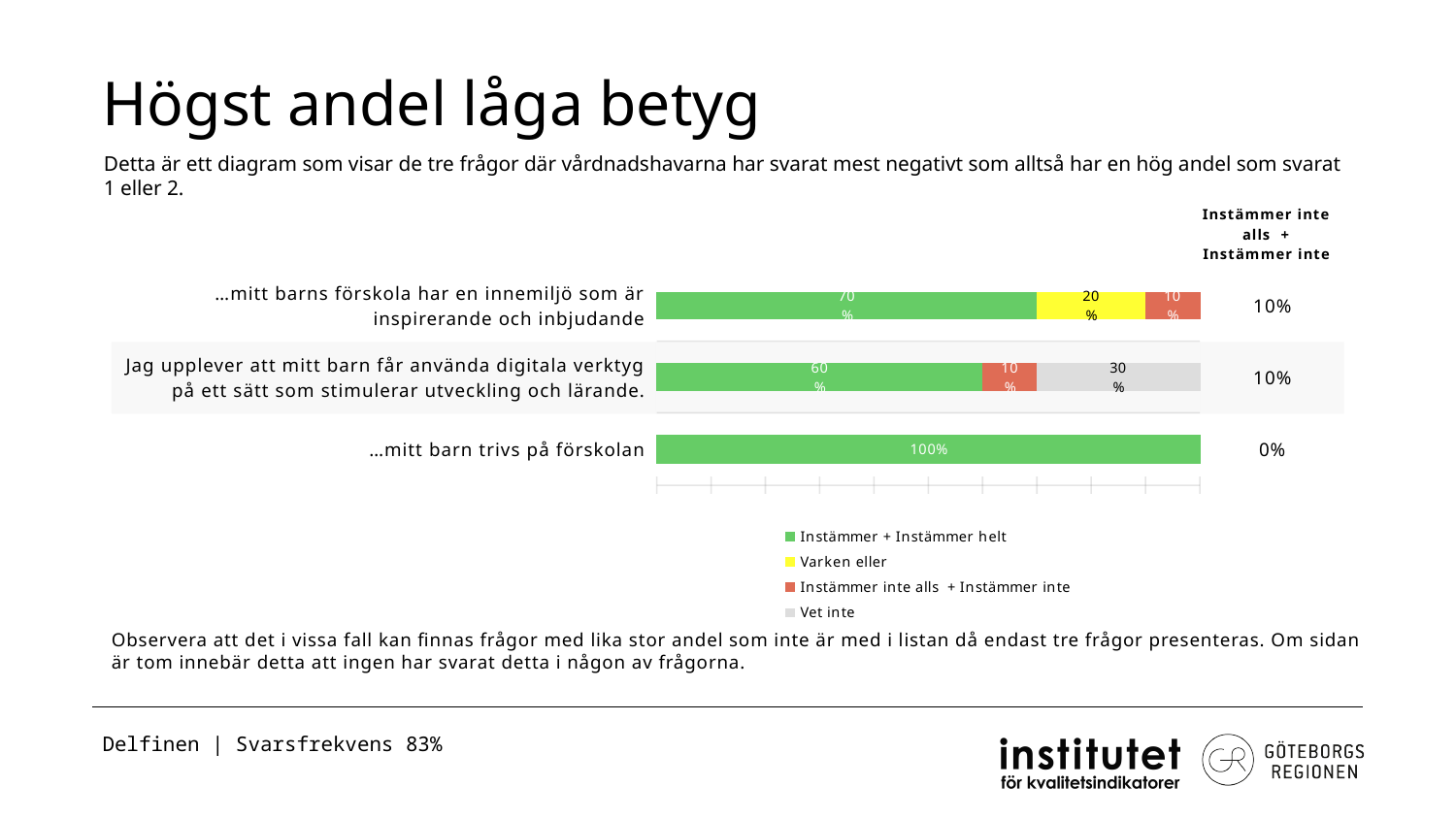
What is the 'Instämmer + Instämmer helt' share for '…mitt barns förskola har en innemiljö som är inspirerande och inbjudande'? 70% What is the difference between the 'Instämmer + Instämmer helt' share for '…mitt barns förskola har en innemiljö som är inspirerande och inbjudande' and for 'Jag upplever att mitt barn får använda digitala verktyg på ett sätt som stimulerar utveckling och lärande.'? 10% What is the title of the slide containing the chart? Högst andel låga betyg What is the 'Varken eller' share for '…mitt barns förskola har en innemiljö som är inspirerande och inbjudande'? 20% How many series does the legend list? 4 Which question has the lowest 'Instämmer + Instämmer helt' share? Jag upplever att mitt barn får använda digitala verktyg på ett sätt som stimulerar utveckling och lärande. How many questions (categories) are plotted in the chart? 3 What is the 'Instämmer + Instämmer helt' share for '…mitt barn trivs på förskolan'? 100% What is the 'Vet inte' share for 'Jag upplever att mitt barn får använda digitala verktyg på ett sätt som stimulerar utveckling och lärande.'? 30% What value is shown in the 'Instämmer inte alls + Instämmer inte' column to the right of the chart for '…mitt barn trivs på förskolan'? 0% What kind of chart is shown on the slide? bar chart Which question has the highest 'Instämmer + Instämmer helt' share? …mitt barn trivs på förskolan